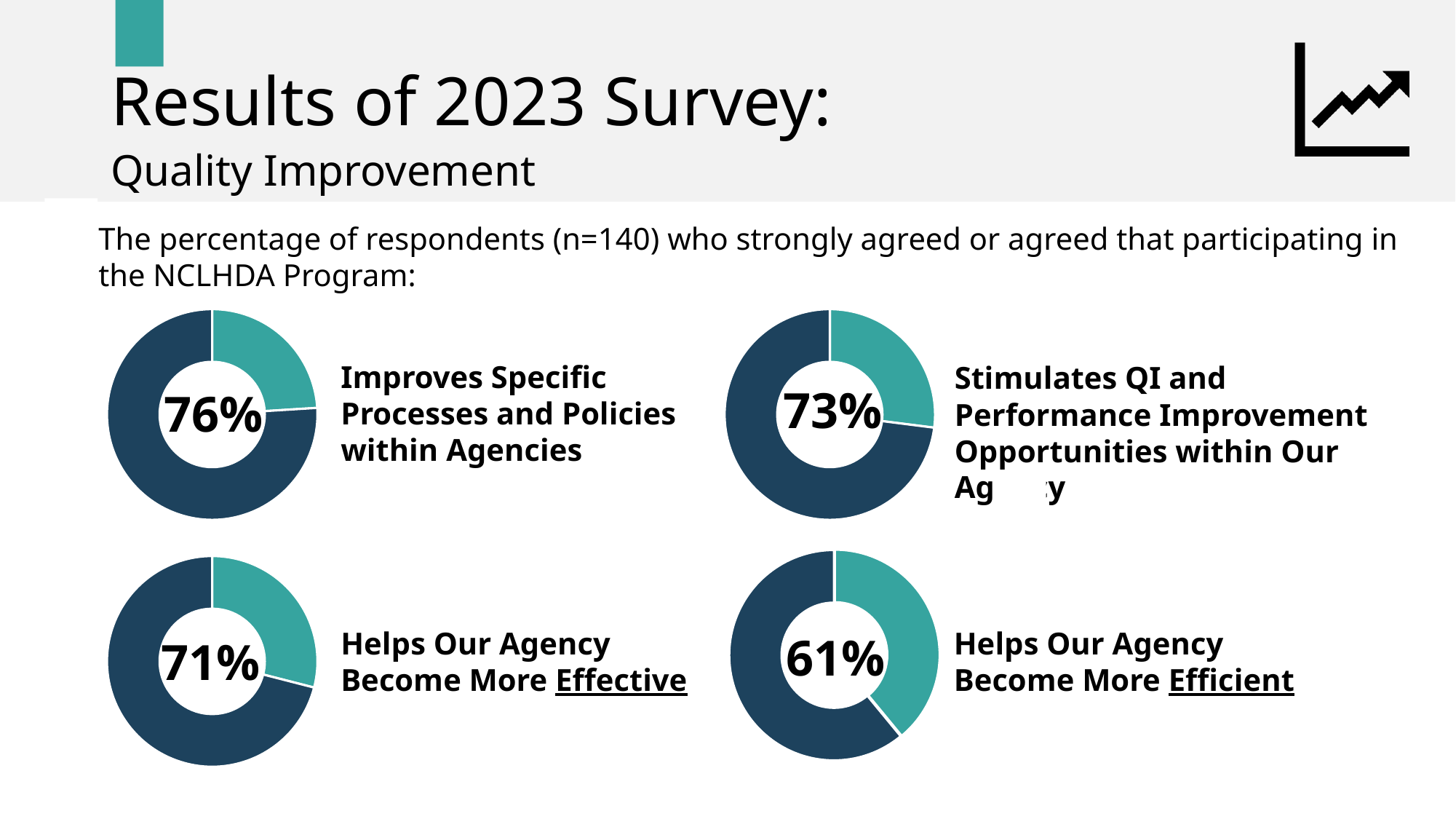
What percentage is shown in the donut chart labelled "Helps Our Agency Become More Efficient"? 61% What is the difference in percentage points between the "Improves Specific Processes and Policies within Agencies" chart and the "Stimulates QI and Performance Improvement Opportunities within Our Agency" chart? 3 percentage points What kind of chart is used to display each percentage on the slide? Donut chart What percentage is shown in the donut chart labelled "Stimulates QI and Performance Improvement Opportunities within Our Agency"? 73% Which of the four donut charts shows the lowest percentage? Helps Our Agency Become More Efficient What is the difference in percentage points between the "Helps Our Agency Become More Effective" chart and the "Helps Our Agency Become More Efficient" chart? 10 percentage points Which of the four donut charts shows the highest percentage? Improves Specific Processes and Policies within Agencies Which is larger: the percentage for "Helps Our Agency Become More Effective" or for "Helps Our Agency Become More Efficient"? Helps Our Agency Become More Effective What percentage is shown in the donut chart labelled "Helps Our Agency Become More Effective"? 71% According to the slide text, how many respondents took part in the 2023 survey? 140 How many donut charts are shown on the slide? 4 What percentage is shown in the donut chart labelled "Improves Specific Processes and Policies within Agencies"? 76%